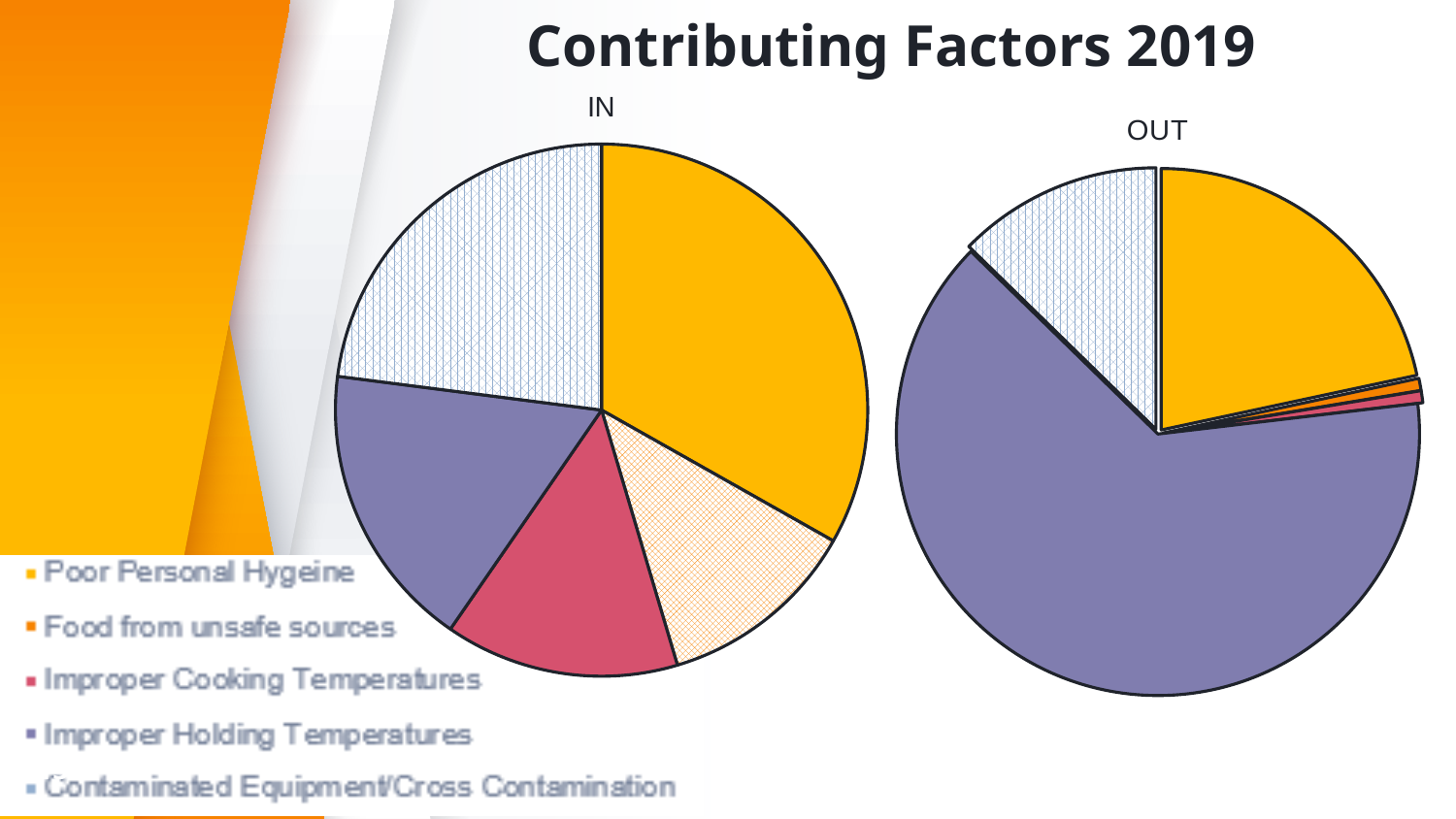
What is the title of the slide's charts? Contributing Factors 2019 What kind of chart is the "OUT" chart? pie chart In the "IN" pie chart, which is larger: Poor Personal Hygeine or Improper Holding Temperatures? Poor Personal Hygeine In the "OUT" pie chart, which is larger: Contaminated Equipment/Cross Contamination or Improper Cooking Temperatures? Contaminated Equipment/Cross Contamination In the "OUT" pie chart, which is larger: Improper Holding Temperatures or Poor Personal Hygeine? Improper Holding Temperatures How many entries does the legend list? 5 In the "IN" pie chart, how many slices are there? 5 What kind of chart is the "IN" chart? pie chart In the "OUT" pie chart, how many slices are there? 5 Which contributing factor is shown in solid purple in the pie charts? Improper Holding Temperatures In the "OUT" pie chart, which contributing factor has the largest slice? Improper Holding Temperatures In the "IN" pie chart, which contributing factor has the largest slice? Poor Personal Hygeine